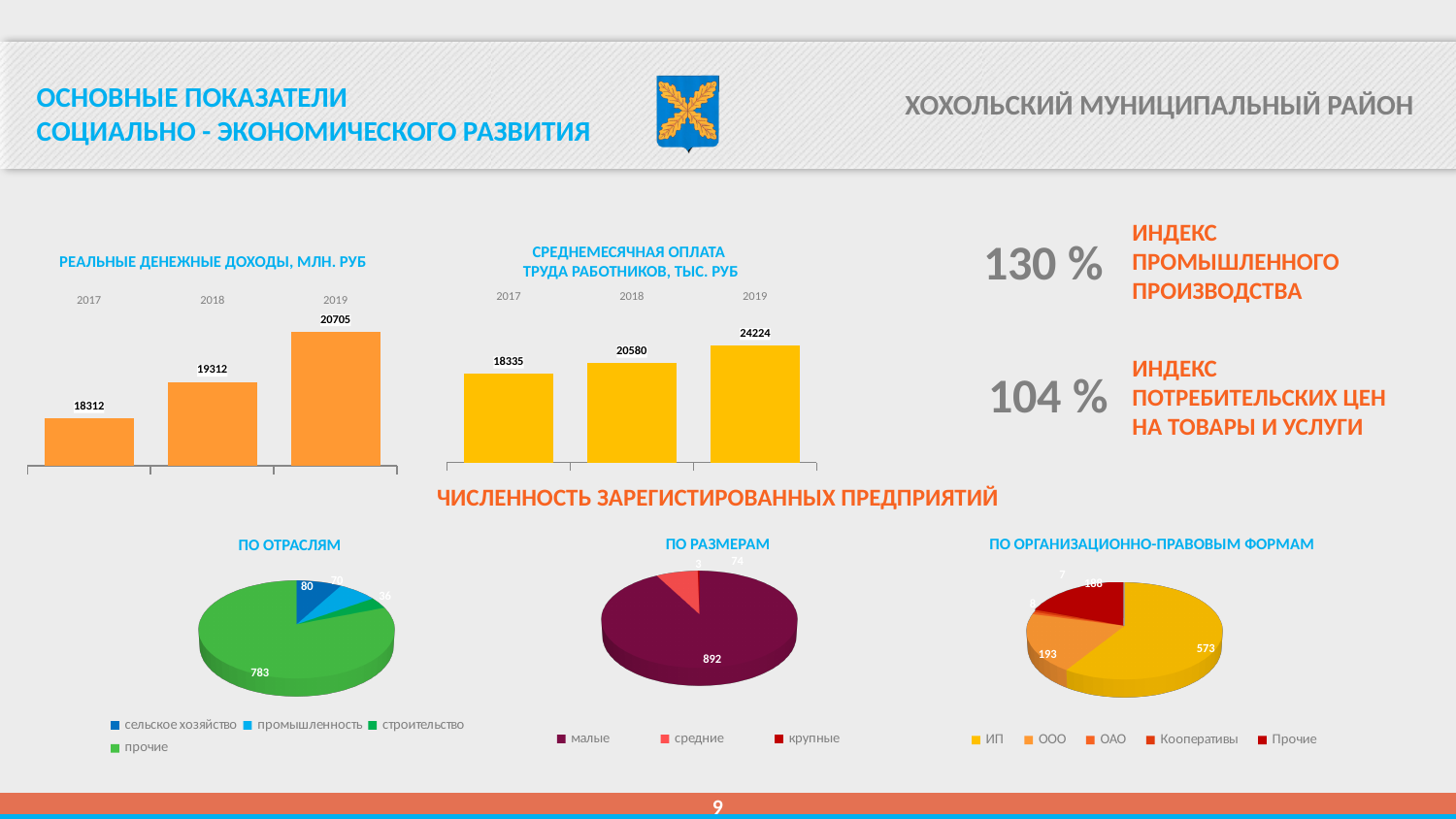
In the pie chart 'ПО ОТРАСЛЯМ', what is the value of the largest slice (прочие)? 783 In the chart 'СРЕДНЕМЕСЯЧНАЯ ОПЛАТА ТРУДА РАБОТНИКОВ, ТЫС. РУБ', what is the value for 2018? 20580 In the chart 'РЕАЛЬНЫЕ ДЕНЕЖНЫЕ ДОХОДЫ, МЛН. РУБ', what is the value for 2017? 18312 In the chart 'СРЕДНЕМЕСЯЧНАЯ ОПЛАТА ТРУДА РАБОТНИКОВ, ТЫС. РУБ', which year has the highest value? 2019 In the pie chart 'ПО ОРГАНИЗАЦИОННО-ПРАВОВЫМ ФОРМАМ', how many categories does the legend list? 5 In the chart 'РЕАЛЬНЫЕ ДЕНЕЖНЫЕ ДОХОДЫ, МЛН. РУБ', what is the value for 2019? 20705 In the pie chart 'ПО РАЗМЕРАМ', what is the value for малые? 892 What kind of chart is 'СРЕДНЕМЕСЯЧНАЯ ОПЛАТА ТРУДА РАБОТНИКОВ, ТЫС. РУБ'? bar chart In the chart 'РЕАЛЬНЫЕ ДЕНЕЖНЫЕ ДОХОДЫ, МЛН. РУБ', do the values rise or fall from 2017 to 2019? rise In the chart 'РЕАЛЬНЫЕ ДЕНЕЖНЫЕ ДОХОДЫ, МЛН. РУБ', what is the difference between the 2019 and 2017 values? 2393 In the chart 'СРЕДНЕМЕСЯЧНАЯ ОПЛАТА ТРУДА РАБОТНИКОВ, ТЫС. РУБ', what is the difference between the 2019 and 2018 values? 3644 How many years are shown in the chart 'РЕАЛЬНЫЕ ДЕНЕЖНЫЕ ДОХОДЫ, МЛН. РУБ'? 3